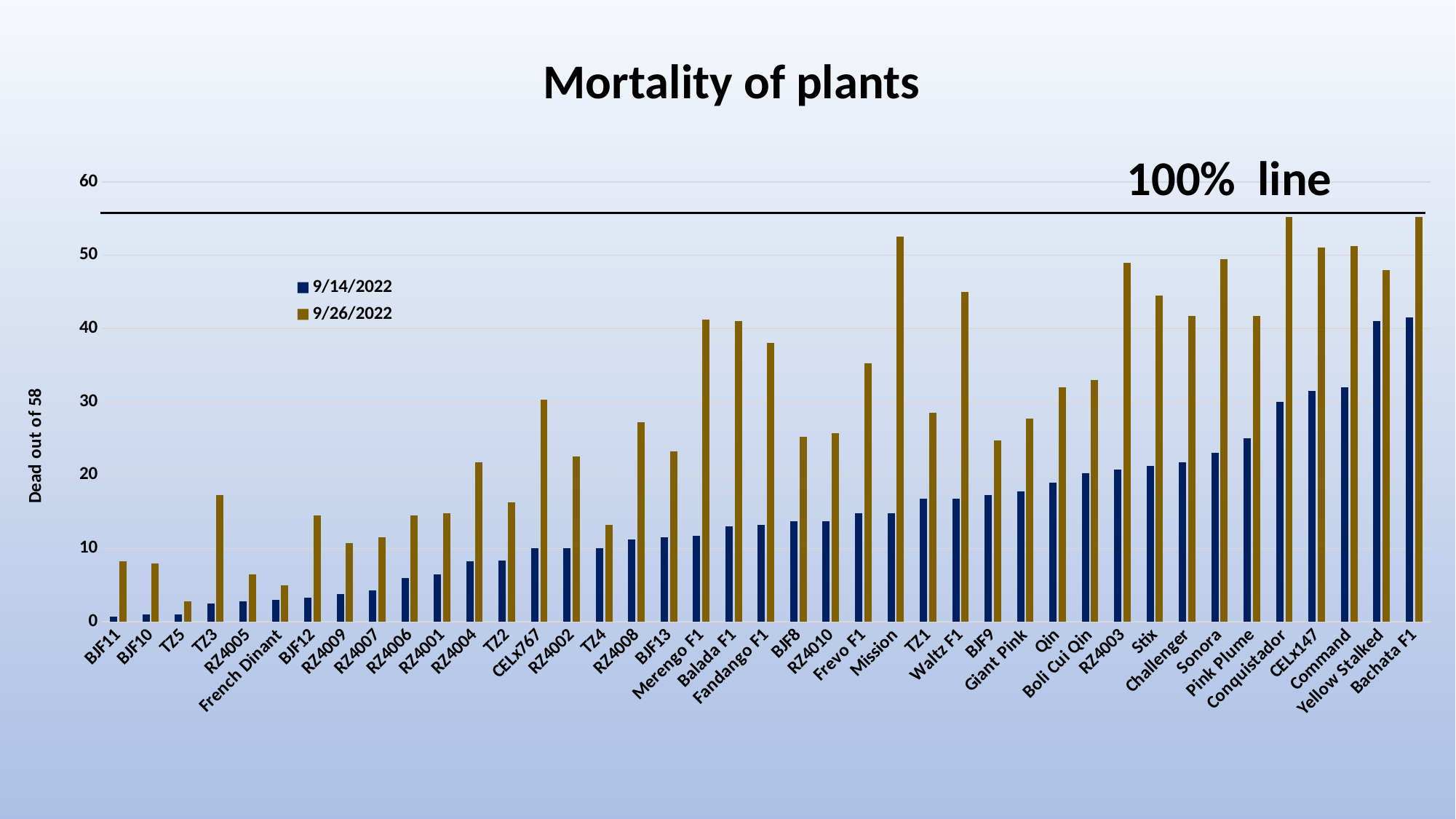
What kind of chart is shown on the slide? bar chart Is the 9/26/2022 value for BJF11 greater or less than 10? less What is the label on the horizontal line drawn near the top of the chart? 100% line Which variety has the lowest 9/26/2022 value? TZ5 Is the 9/14/2022 value for Qin greater or less than 20? less What is the title of the y axis? Dead out of 58 How many plant varieties (categories) are shown on the x axis? 41 Is the 9/26/2022 value for Mission greater or less than 50? greater Do the 9/14/2022 values generally rise or fall from left to right along the x axis? rise Which is larger, the 9/26/2022 value for Mission or the 9/26/2022 value for Frevo F1? Mission How many series does the legend list? 2